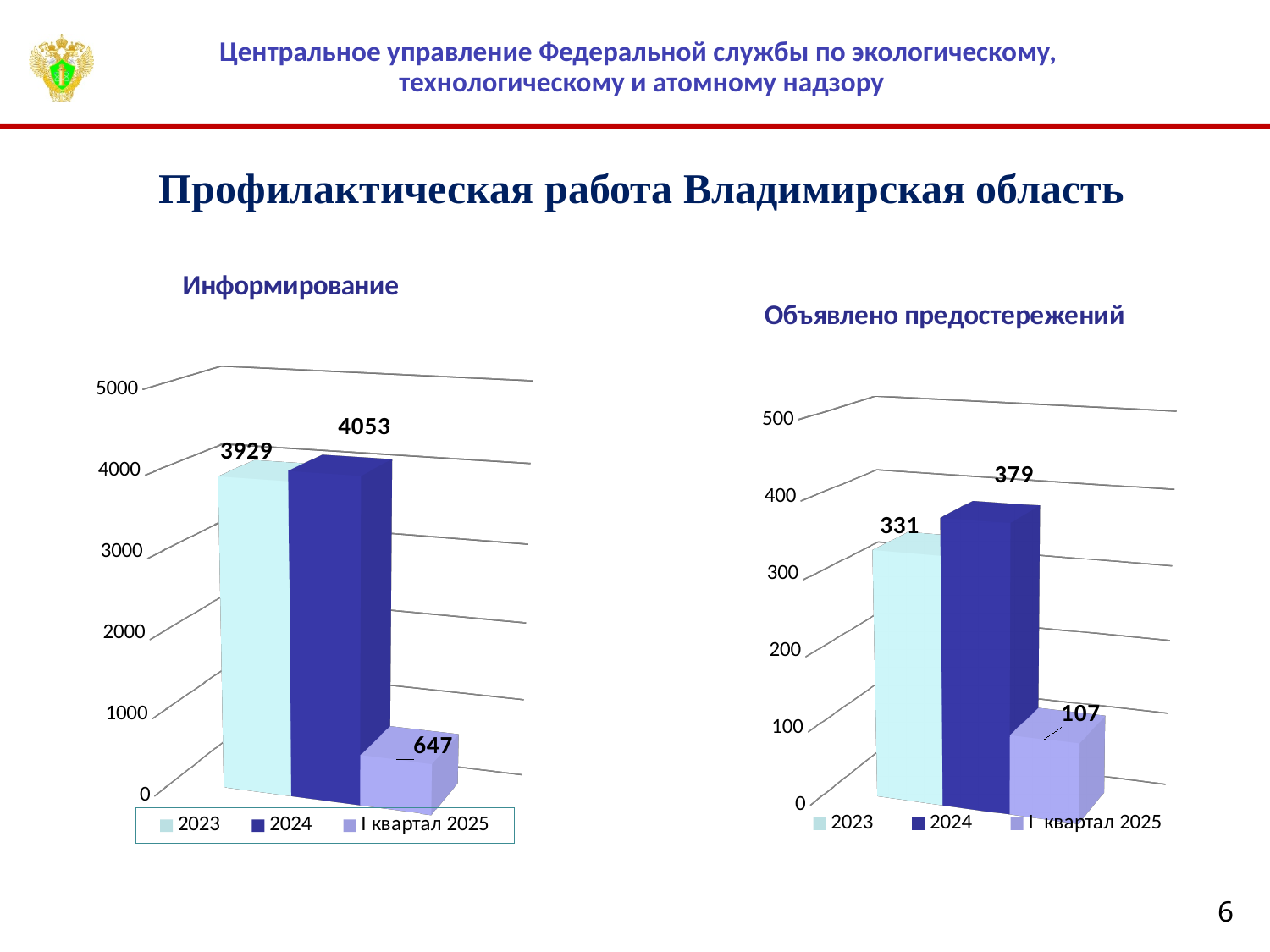
In the 'Объявлено предостережений' chart, what is the difference between the 2024 and 2023 values? 48 In the 'Объявлено предостережений' chart, which series has the highest value? 2024 How many series does the legend of the 'Информирование' chart list? 3 In the 'Объявлено предостережений' chart, what is the value for I квартал 2025? 107 In the 'Информирование' chart, what is the value for I квартал 2025? 647 In the 'Информирование' chart, which series has the lowest value? I квартал 2025 What kind of chart is the 'Объявлено предостережений' chart? bar chart In the 'Информирование' chart, what is the value for 2024? 4053 In the 'Объявлено предостережений' chart, which is larger: the value for 2023 or for I квартал 2025? 2023 In the 'Информирование' chart, what is the value for 2023? 3929 In the 'Информирование' chart, what is the difference between the 2024 and 2023 values? 124 In the 'Объявлено предостережений' chart, what is the value for 2024? 379